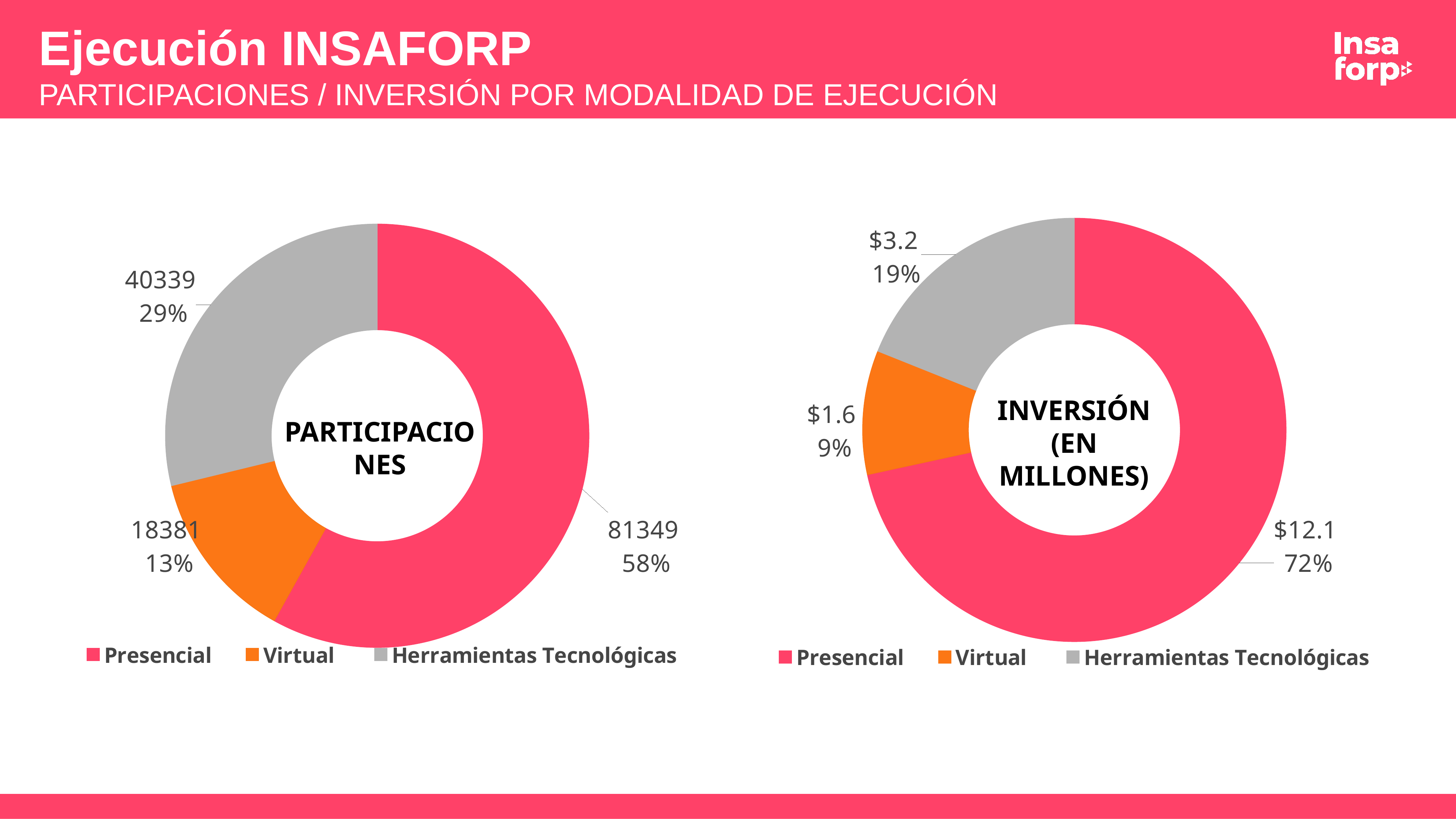
What kind of chart is the PARTICIPACIONES chart? Doughnut (pie) chart In the PARTICIPACIONES chart, what is the difference between Presencial and Herramientas Tecnológicas? 41010 In the INVERSIÓN (EN MILLONES) chart, what is the value for Virtual? $1.6 In the PARTICIPACIONES chart, what is the value for Presencial? 81349 In the PARTICIPACIONES chart, what is the value for Virtual? 18381 In the PARTICIPACIONES chart, what is the value for Herramientas Tecnológicas? 40339 In the PARTICIPACIONES chart, which category has the lowest value? Virtual In the PARTICIPACIONES chart, what share of the total does Herramientas Tecnológicas represent? 29% In the INVERSIÓN (EN MILLONES) chart, what is the value for Presencial? $12.1 In the INVERSIÓN (EN MILLONES) chart, which is larger, Virtual or Herramientas Tecnológicas? Herramientas Tecnológicas In the INVERSIÓN (EN MILLONES) chart, which category has the highest value? Presencial In the INVERSIÓN (EN MILLONES) chart, what share of the total does Herramientas Tecnológicas represent? 19%